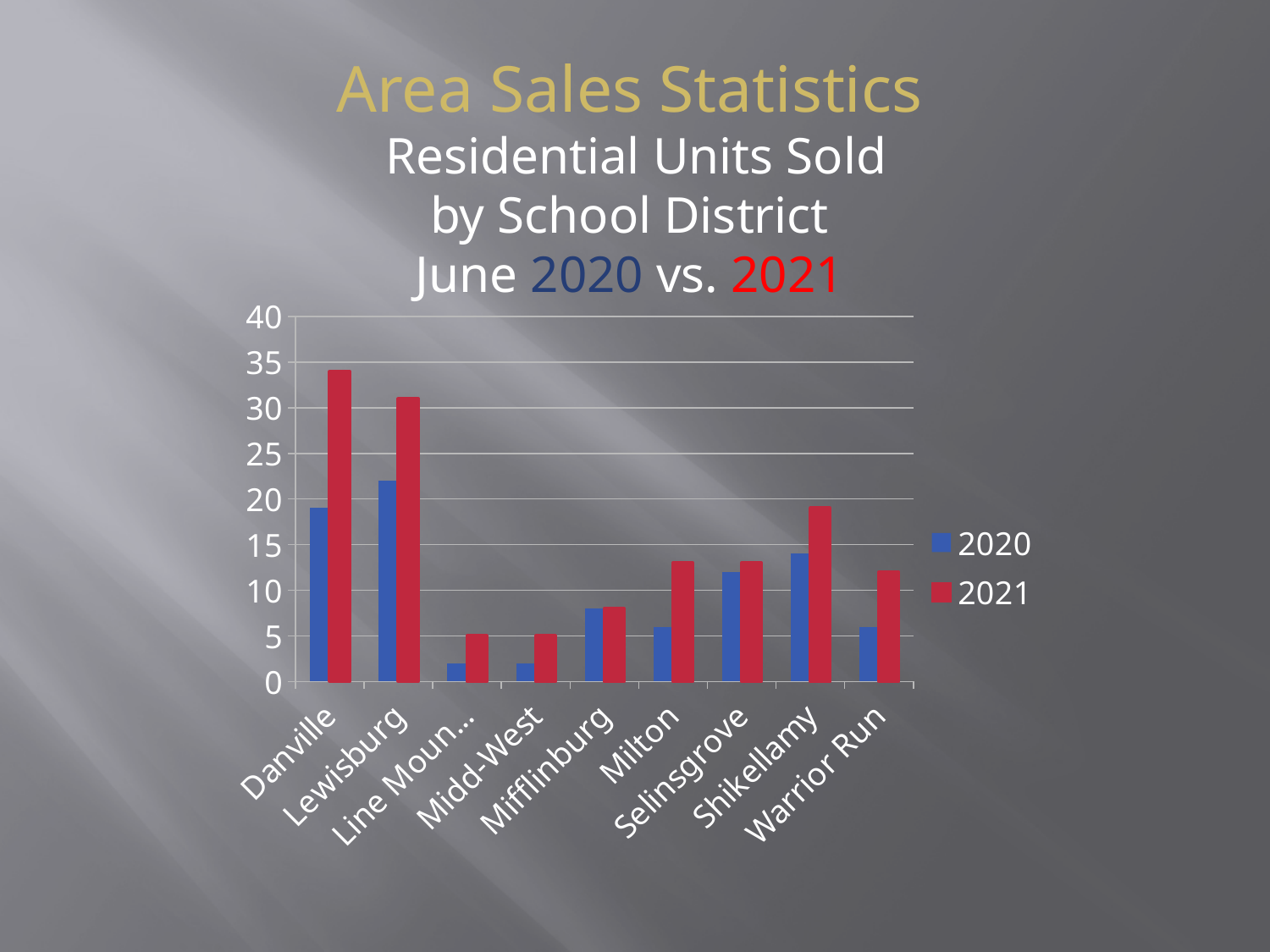
Is the 2020 value for Midd-West greater or less than 5? less Which school district has the highest 2020 bar? Lewisburg Which is larger, the 2021 value for Shikellamy or the 2021 value for Warrior Run? Shikellamy What colour represents the 2021 series in the chart's legend? red Is the 2021 value for Warrior Run greater or less than 10? greater Is the 2021 value for Danville greater or less than 30? greater How many school districts are shown on the x axis of the chart? 9 Which school district has the highest 2021 bar? Danville How many series does the chart's legend list? 2 Which is larger, the 2020 value for Milton or the 2020 value for Selinsgrove? Selinsgrove What kind of chart is shown on the slide? bar chart